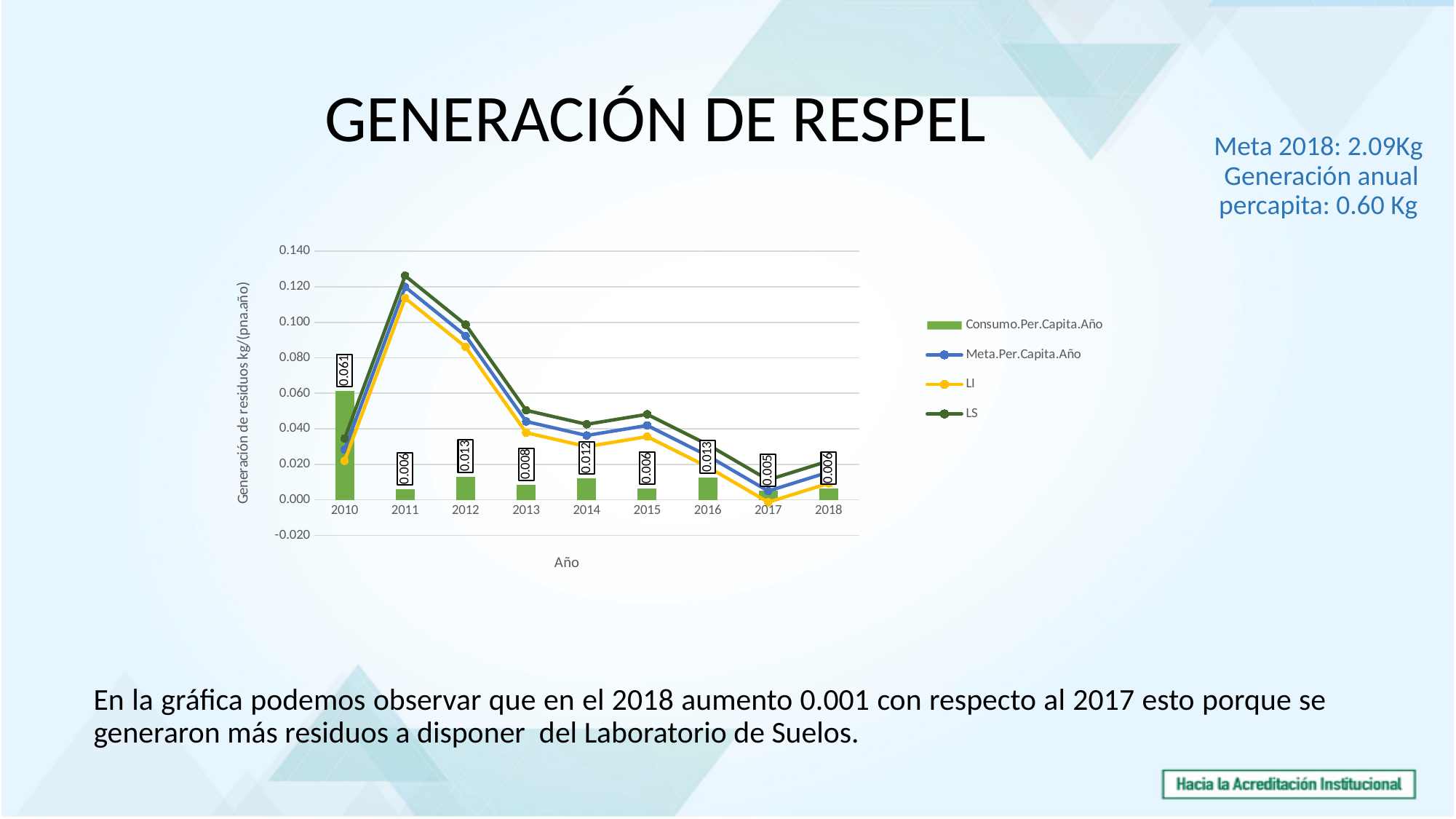
What is the Consumo.Per.Capita.Año value for 2010? 0.061 Is the LS value for 2011 greater or less than 0.100? greater What is the Consumo.Per.Capita.Año value for 2017? 0.005 Which year has the lowest Consumo.Per.Capita.Año value? 2017 What is the Consumo.Per.Capita.Año value for 2014? 0.012 Which year has the highest Consumo.Per.Capita.Año value? 2010 What is the difference between the Consumo.Per.Capita.Año values for 2012 and 2013? 0.005 How many series does the legend list? 4 Is the LI value for 2013 greater or less than 0.060? less Does the LS line rise or fall from 2011 to 2013? fall Which year has a larger Consumo.Per.Capita.Año value, 2014 or 2015? 2014 How many years are shown on the x axis? 9